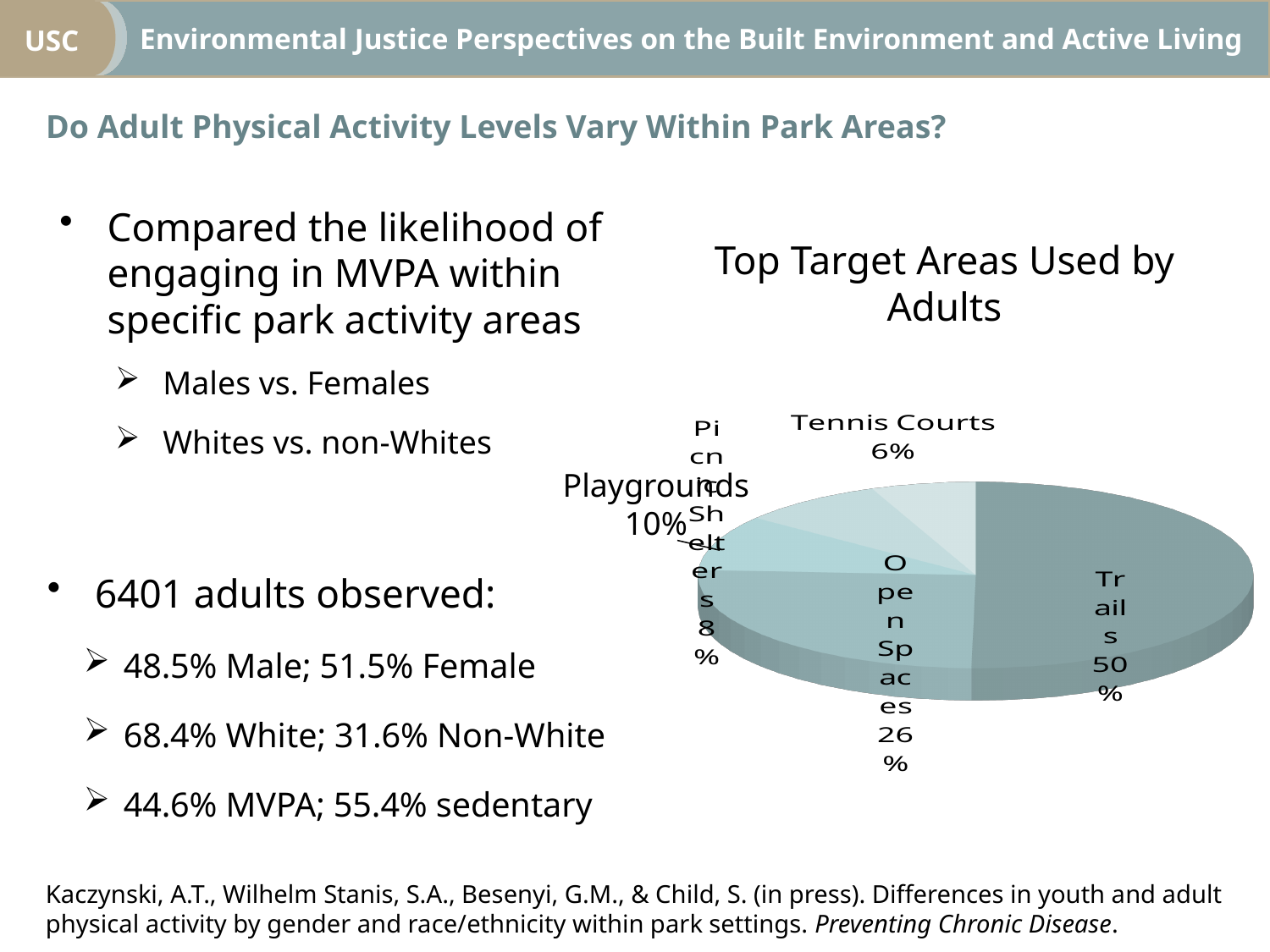
What is the difference in percentage points between Trails and Open Spaces? 24 Which target area has the smallest share of the pie? Tennis Courts What share of the pie is Tennis Courts? 6% What kind of chart is shown on the slide? pie chart Which target area has the largest share of the pie? Trails What share of the pie is Playgrounds? 10% What share of the pie is Trails? 50% Which is larger, the share for Playgrounds or the share for Picnic Shelters? Playgrounds How many slices does the pie chart have? 5 What is the title of the chart? Top Target Areas Used by Adults What share of the pie is Open Spaces? 26% What share of the pie is Picnic Shelters? 8%